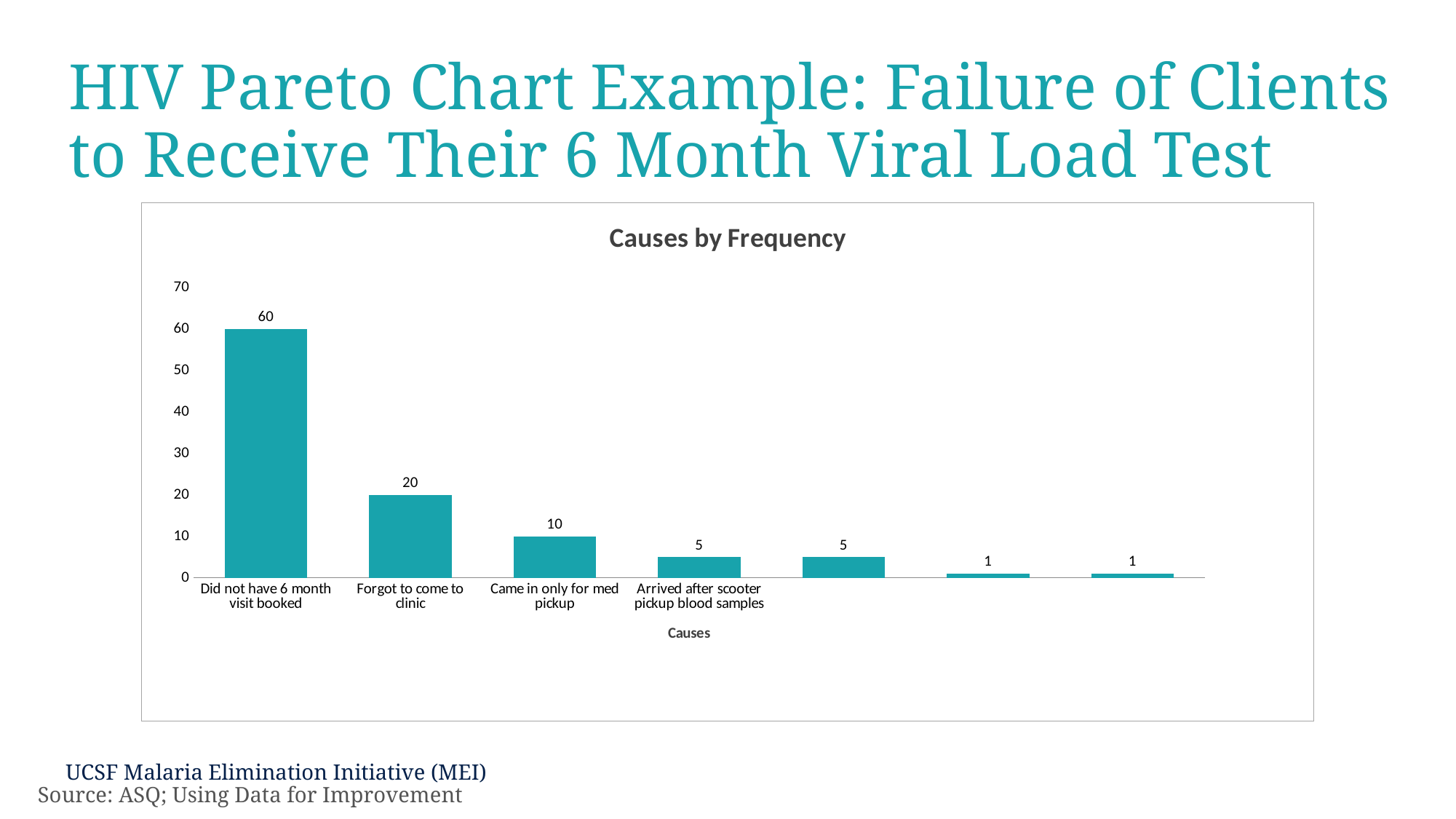
What kind of chart is shown on the slide? Bar chart Do the values rise or fall from left to right along the x axis? Fall What is the value for "Forgot to come to clinic"? 20 Which is larger, the value for "Forgot to come to clinic" or the value for "Came in only for med pickup"? Forgot to come to clinic What is the difference between the values for "Did not have 6 month visit booked" and "Forgot to come to clinic"? 40 What is the difference between the values for "Came in only for med pickup" and "Arrived after scooter pickup blood samples"? 5 What is the value for "Arrived after scooter pickup blood samples"? 5 How many bars are plotted in the chart? 7 What is the value for "Came in only for med pickup"? 10 Which cause has the highest frequency? Did not have 6 month visit booked What is the value for "Did not have 6 month visit booked"? 60 What is the title of the chart? Causes by Frequency